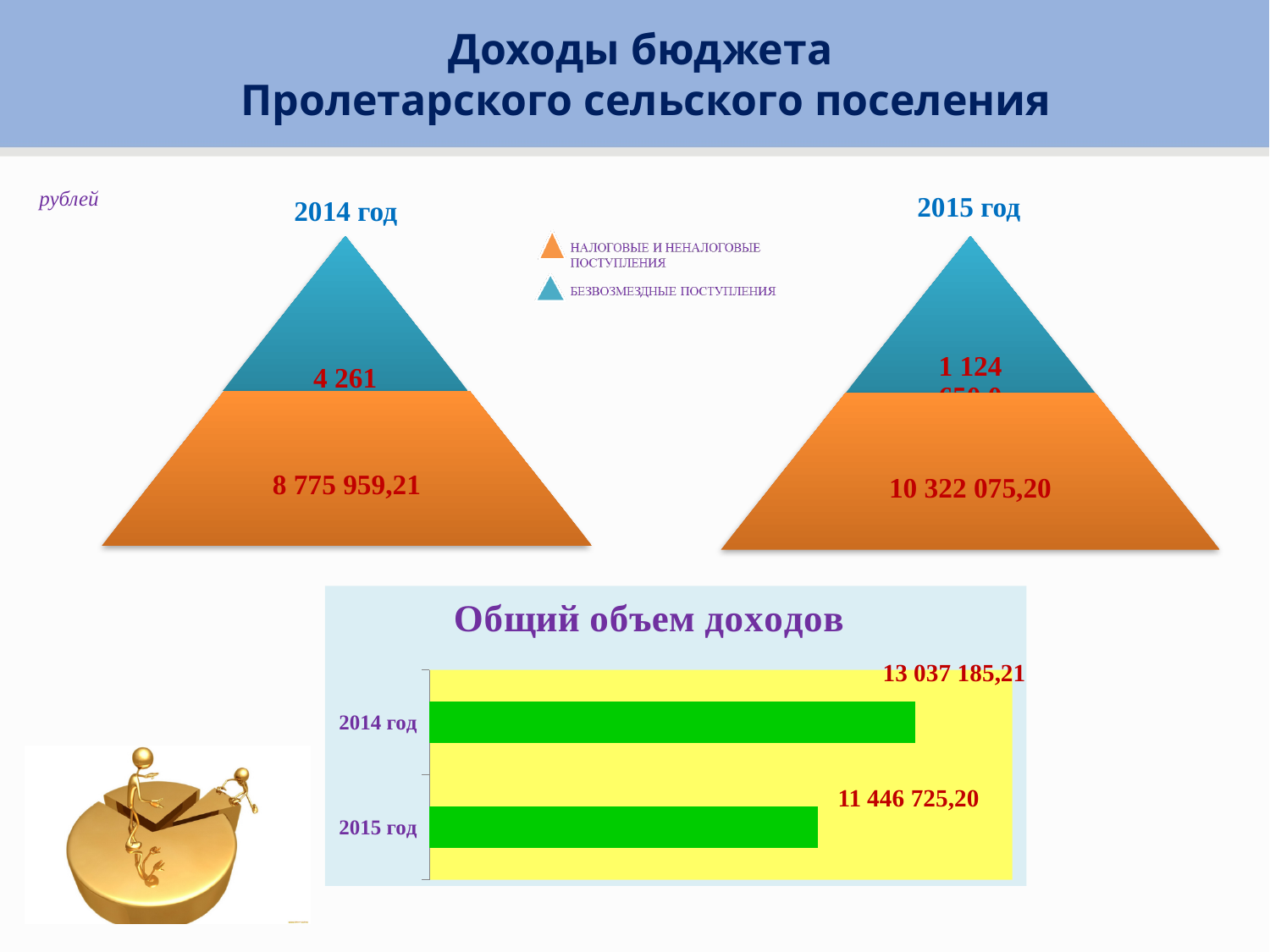
In the 'Общий объем доходов' chart, what is the value for 2015 год? 11 446 725,20 What is the difference between the налоговые и неналоговые поступления values for 2015 год and 2014 год in the pyramid charts? 1 546 115,99 What kind of chart is 'Общий объем доходов'? bar chart In the 'Общий объем доходов' chart, what is the value for 2014 год? 13 037 185,21 In the 'Общий объем доходов' chart, what is the difference between the 2014 год and 2015 год values? 1 590 460,01 In the 2015 год pyramid chart, what is the value for налоговые и неналоговые поступления? 10 322 075,20 How many entries does the legend of the pyramid charts list? 2 In the 2014 год pyramid chart, what is the value for налоговые и неналоговые поступления? 8 775 959,21 In the 'Общий объем доходов' chart, how many bars are plotted? 2 In the 'Общий объем доходов' chart, which year has the lower value? 2015 год Comparing the pyramid charts, which year has the larger value for налоговые и неналоговые поступления, 2014 год or 2015 год? 2015 год In the 'Общий объем доходов' chart, which year has the higher value? 2014 год